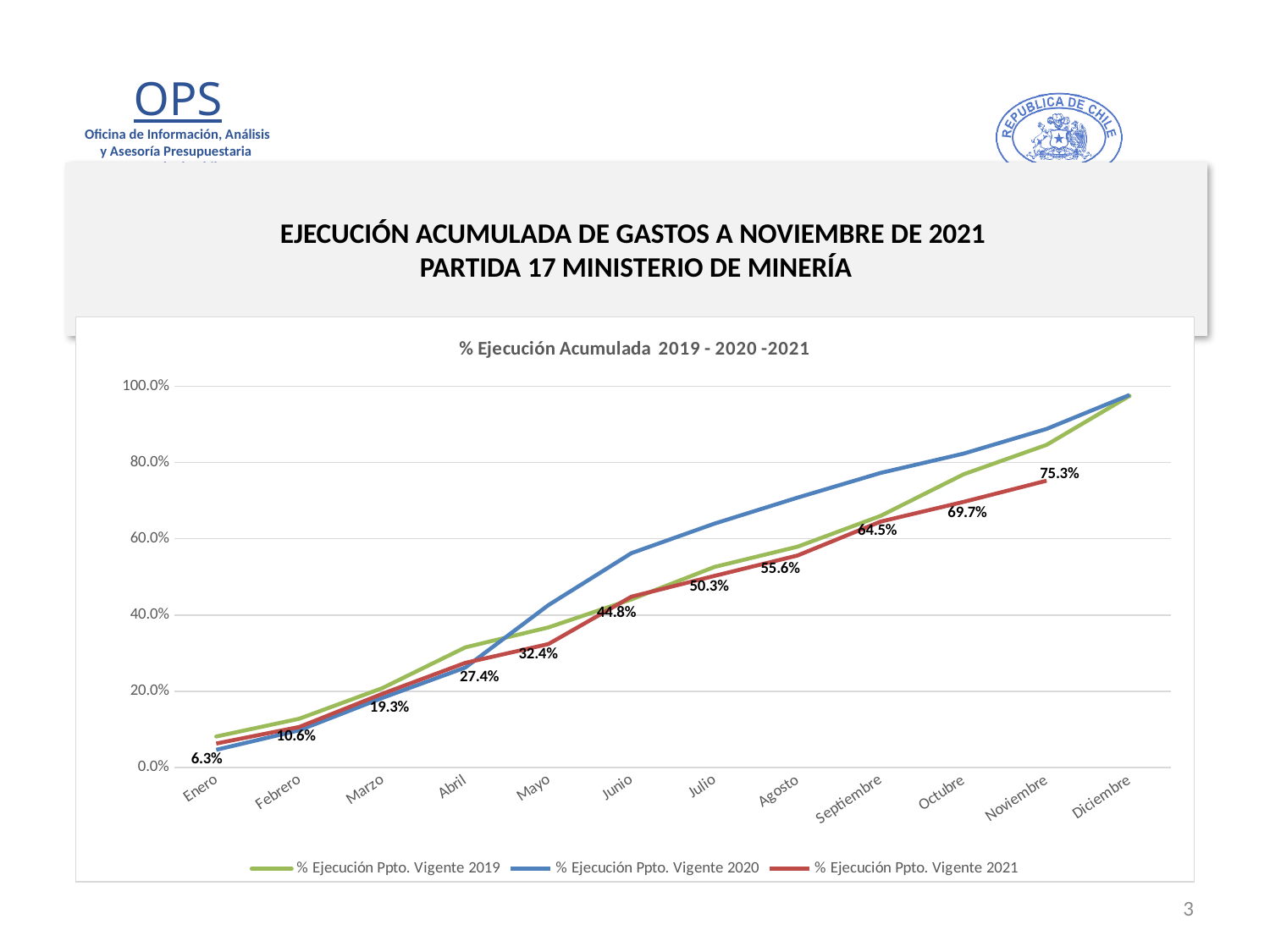
How many series does the legend list? 3 Is the value for % Ejecución Ppto. Vigente 2020 in Junio greater or less than 40.0%? greater What is the value for % Ejecución Ppto. Vigente 2021 in Septiembre? 64.5% Do the values of the % Ejecución Ppto. Vigente 2021 series rise or fall from Enero to Noviembre? Rise What is the value for % Ejecución Ppto. Vigente 2021 in Junio? 44.8% In Junio, which series is higher: % Ejecución Ppto. Vigente 2020 or % Ejecución Ppto. Vigente 2021? % Ejecución Ppto. Vigente 2020 What is the value for % Ejecución Ppto. Vigente 2021 in Enero? 6.3% What kind of chart is shown on the slide? Line chart In which month does the % Ejecución Ppto. Vigente 2021 series reach its highest value? Noviembre What is the difference between the % Ejecución Ppto. Vigente 2021 values for Noviembre and Octubre? 5.6% In which month does the % Ejecución Ppto. Vigente 2021 series have its lowest value? Enero What is the value for % Ejecución Ppto. Vigente 2021 in Noviembre? 75.3%